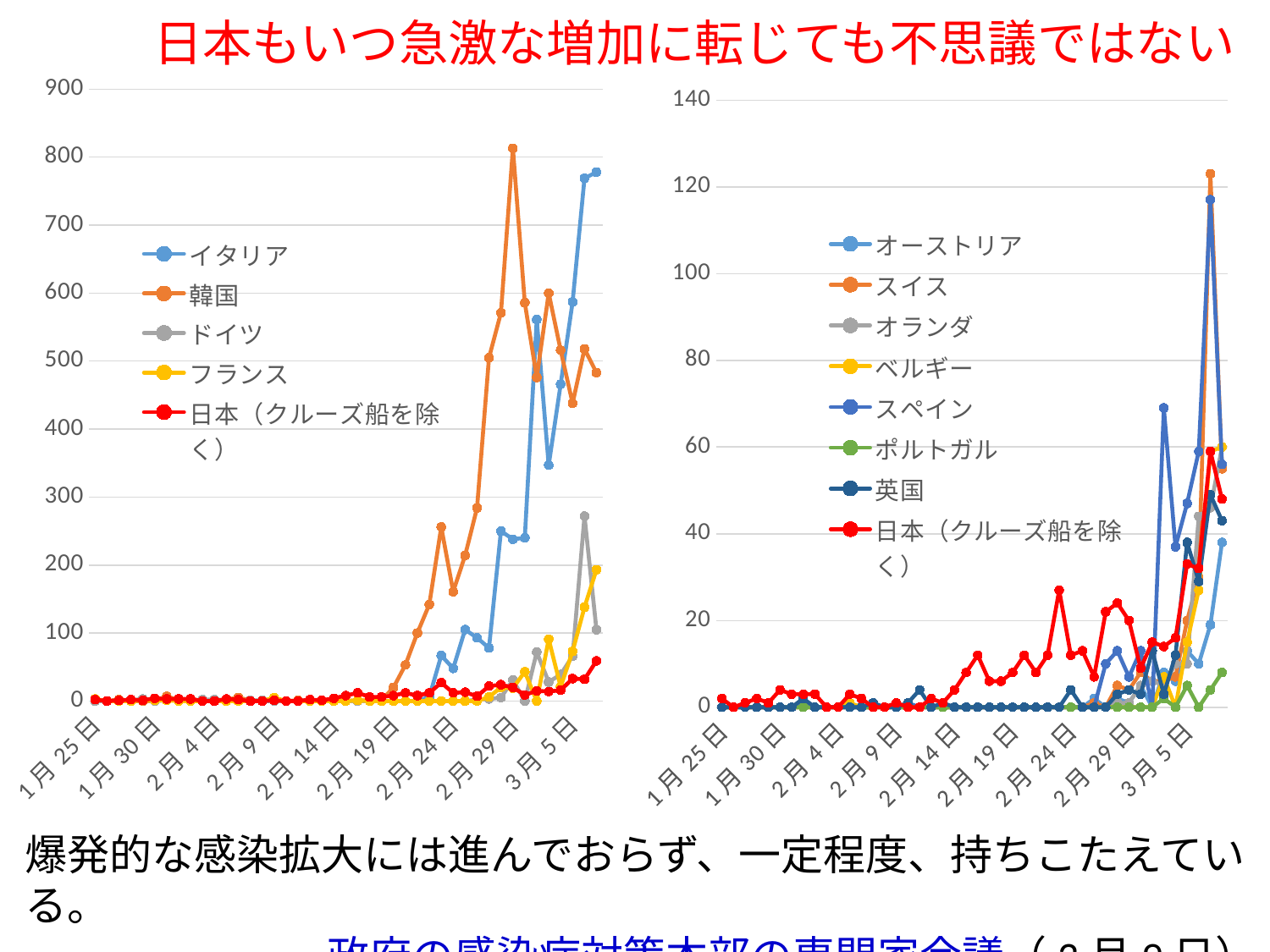
In the right chart, is the highest value for ポルトガル greater or less than 20? less How many series does the legend of the left chart list? 5 How many series does the legend of the right chart list? 8 What kind of chart is the left chart on the slide? line chart In the right chart, which series has a higher peak value, スペイン or ポルトガル? スペイン In the left chart, is the peak value for 韓国 greater or less than 800? greater In the left chart, which series has a higher final value, イタリア or フランス? イタリア In the left chart, what colour is the line for 日本（クルーズ船を除く）? red In the right chart, which series reaches the highest value on the chart? スイス In the left chart, is the highest value for 日本（クルーズ船を除く） greater or less than 100? less In the left chart, which series reaches the highest value on the chart? 韓国